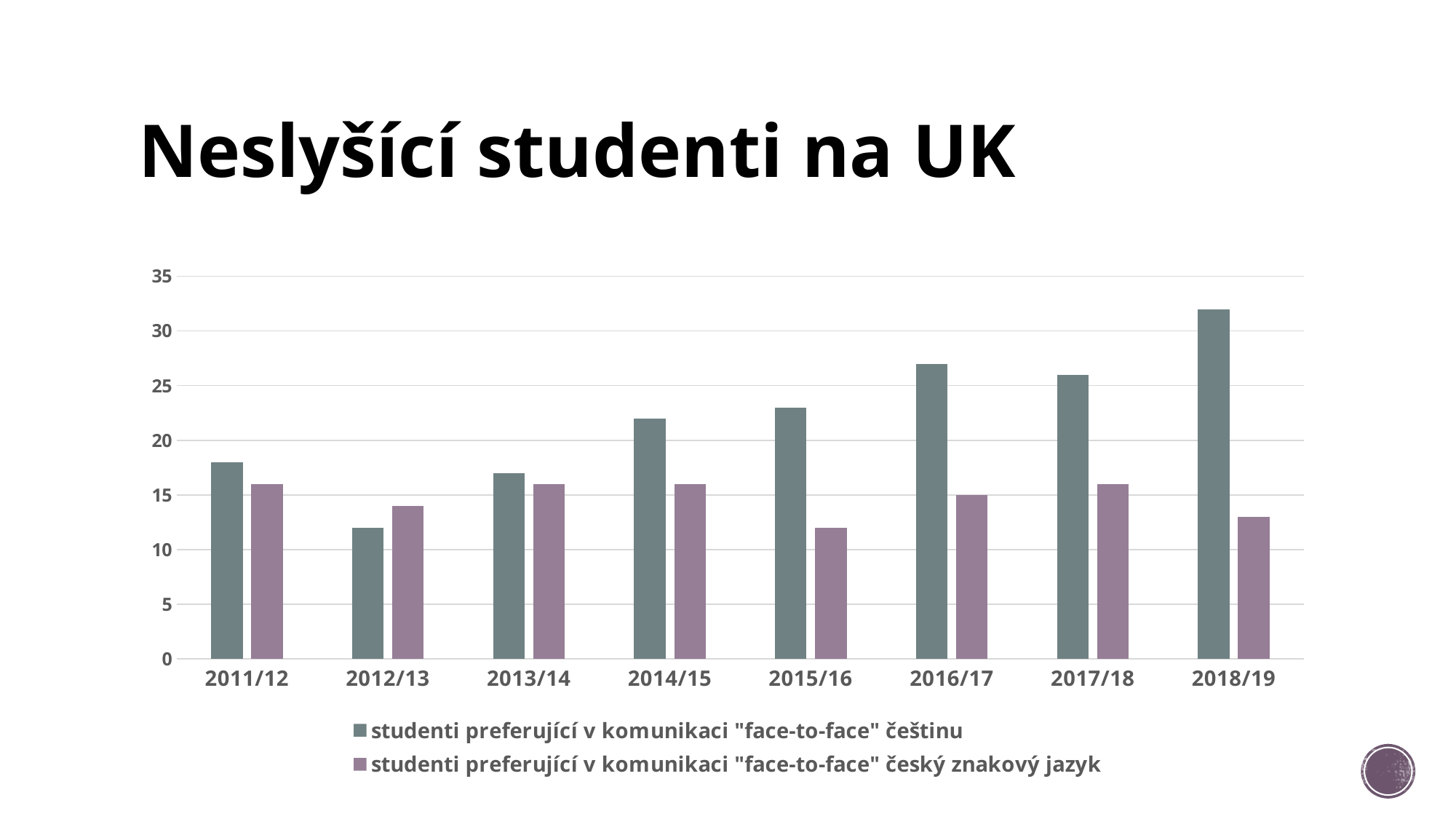
Is the value for students preferring Czech sign language (český znakový jazyk) in 2015/16 greater or less than 15? less Is the value for students preferring Czech (čeština) in 2014/15 greater or less than 20? greater What kind of chart is shown on the slide? bar chart What is the title of the slide? Neslyšící studenti na UK In which academic year is the value for students preferring Czech (čeština) in face-to-face communication the lowest? 2012/13 Is the value for students preferring Czech (čeština) in 2012/13 greater or less than 15? less How many series does the legend list? 2 In 2018/19, which is larger: the value for students preferring Czech (čeština) or the value for students preferring Czech sign language (český znakový jazyk)? students preferring Czech (čeština) How many academic years are shown on the x axis? 8 Does the value for students preferring Czech (čeština) generally rise or fall from 2012/13 to 2018/19? rise In which academic year is the value for students preferring Czech (čeština) in face-to-face communication the highest? 2018/19